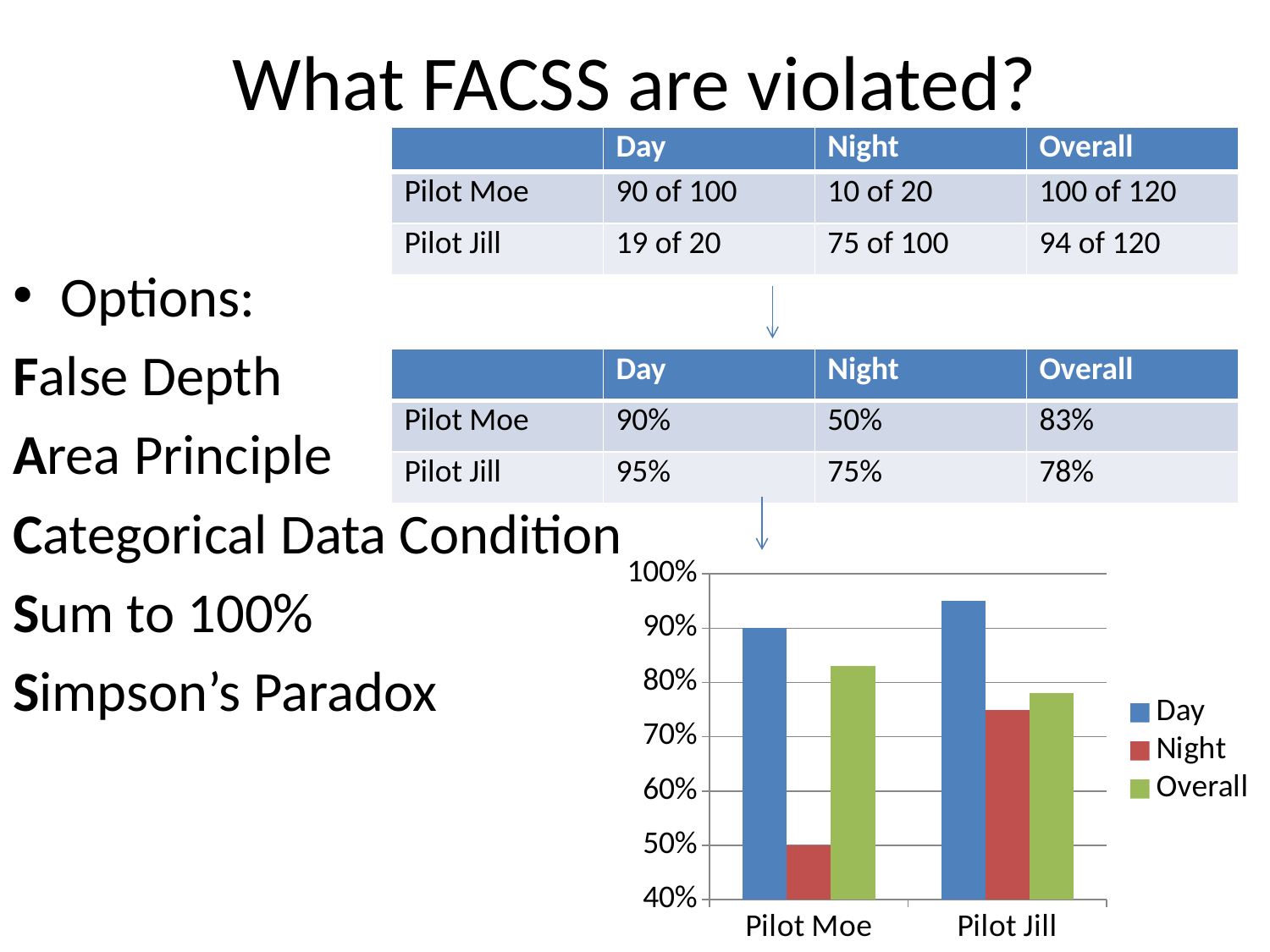
What is the Night value for Pilot Moe in the chart? 50% Which series has the highest value for Pilot Jill? Day Is the Night value for Pilot Jill greater or less than 80%? less What is the Day value for Pilot Moe in the chart? 90% Is the Day value for Pilot Jill greater or less than 90%? greater Which series has the lowest value for Pilot Moe? Night How many categories are shown on the x axis of the chart? 2 What is the Overall value for Pilot Jill in the chart? 78% Which is larger, the Overall value for Pilot Moe or the Overall value for Pilot Jill? Pilot Moe What is the difference between the Night values for Pilot Jill and Pilot Moe? 25% How many series does the chart legend list? 3 What kind of chart is shown on the slide? bar chart